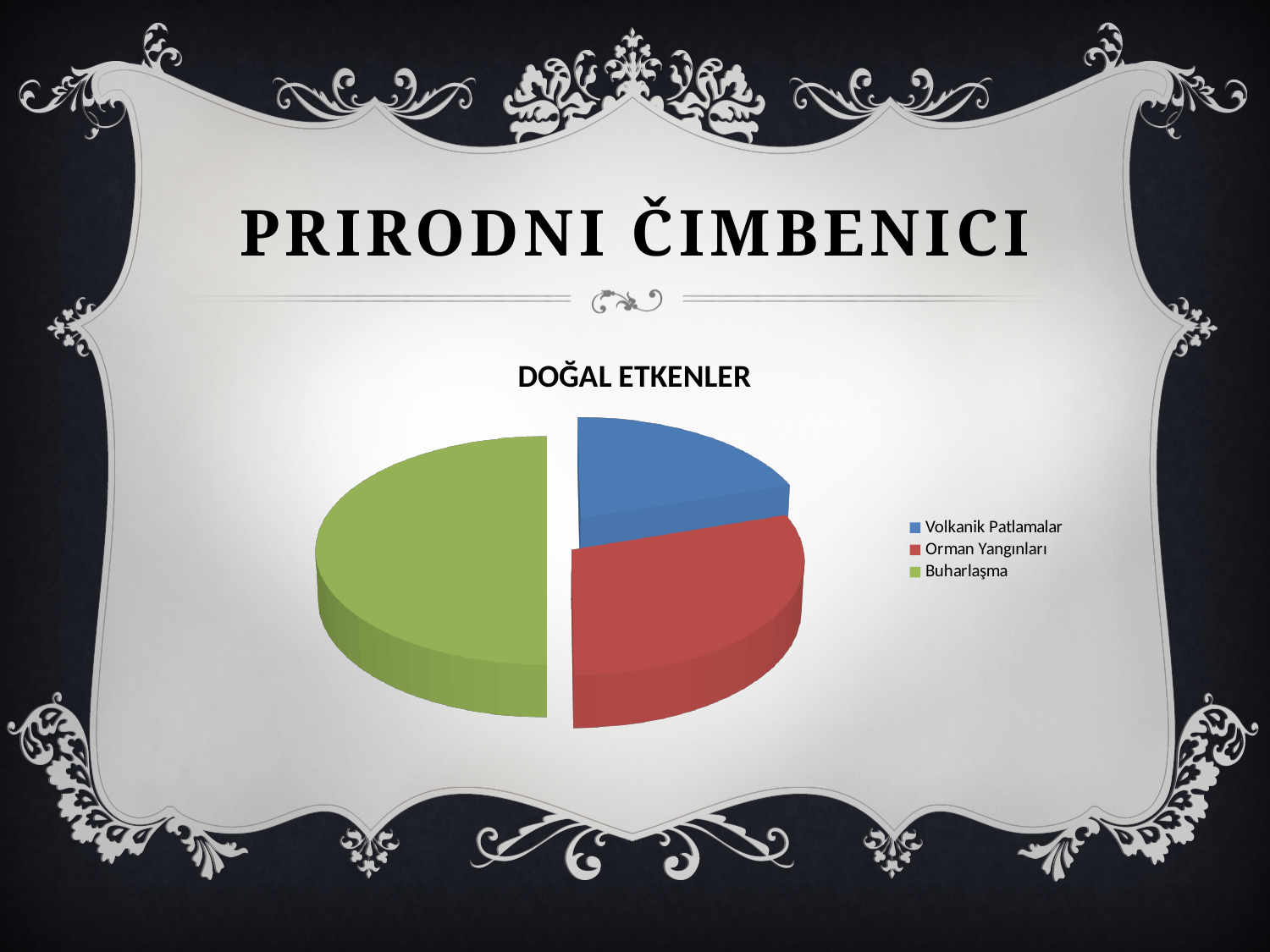
Which slice is larger, Buharlaşma or Orman Yangınları? Buharlaşma Which category has the largest slice of the pie? Buharlaşma How many slices does the pie chart have? 3 Which category has the smallest slice of the pie? Volkanik Patlamalar Which slice is larger, Volkanik Patlamalar or Orman Yangınları? Orman Yangınları How many entries does the legend list? 3 What kind of chart is shown on the slide? pie chart Which colour represents Orman Yangınları in the pie chart? red What is the title of the chart? DOĞAL ETKENLER